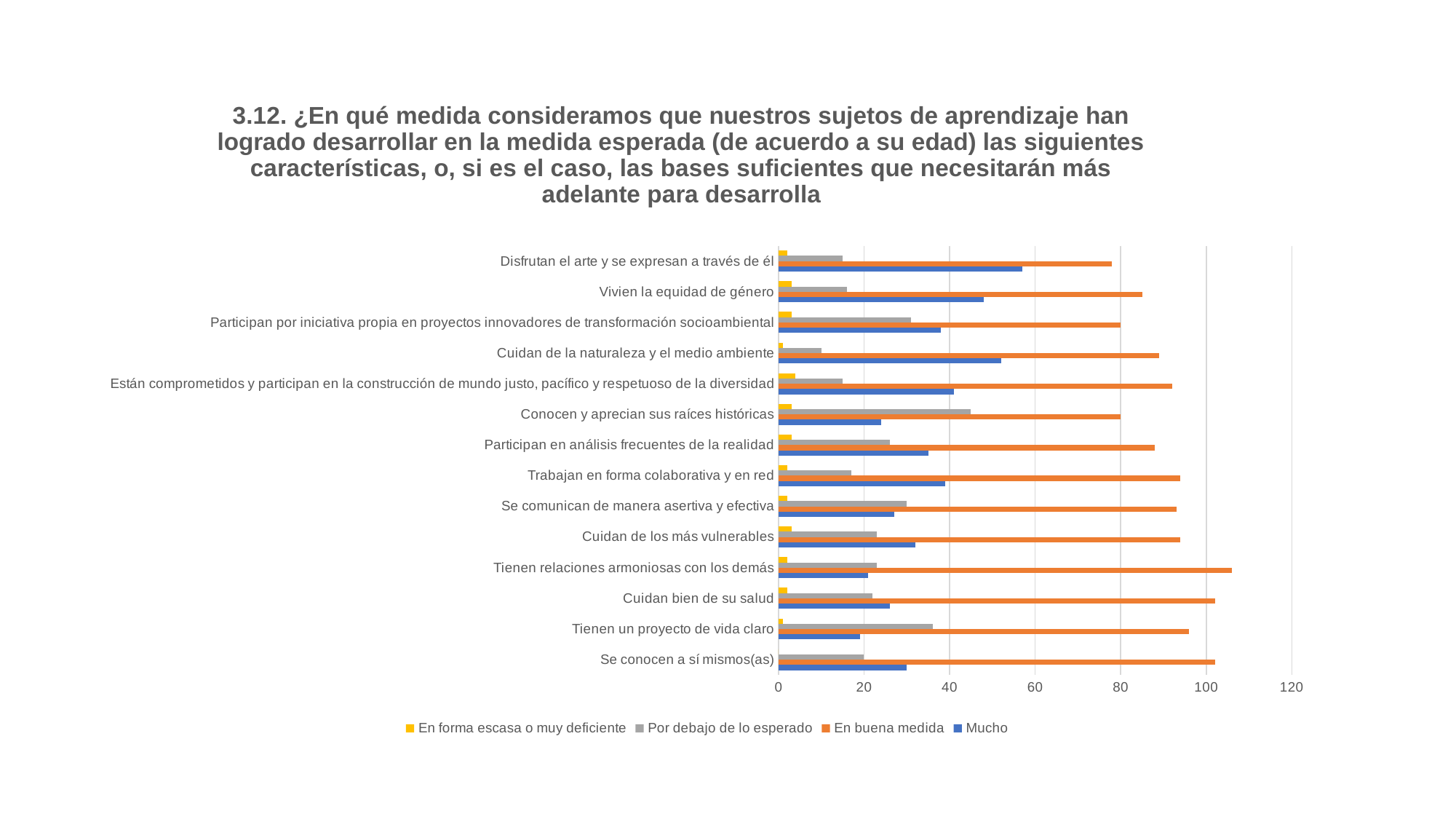
Which is larger: the 'Mucho' value for 'Disfrutan el arte y se expresan a través de él' or the 'Mucho' value for 'Se conocen a sí mismos(as)'? Disfrutan el arte y se expresan a través de él Is the 'Por debajo de lo esperado' value for 'Cuidan de la naturaleza y el medio ambiente' greater or less than 20? less Is the 'Por debajo de lo esperado' value for 'Conocen y aprecian sus raíces históricas' greater or less than 40? greater What kind of chart is shown on the slide? bar chart Is the 'Mucho' value for 'Cuidan de la naturaleza y el medio ambiente' greater or less than 40? greater How many categories are listed on the vertical axis of the chart? 14 How many series does the chart's legend list? 4 Which is larger: the 'En buena medida' value for 'Disfrutan el arte y se expresan a través de él' or the 'En buena medida' value for 'Cuidan bien de su salud'? Cuidan bien de su salud Which colour represents the 'Mucho' series in the chart's legend? blue